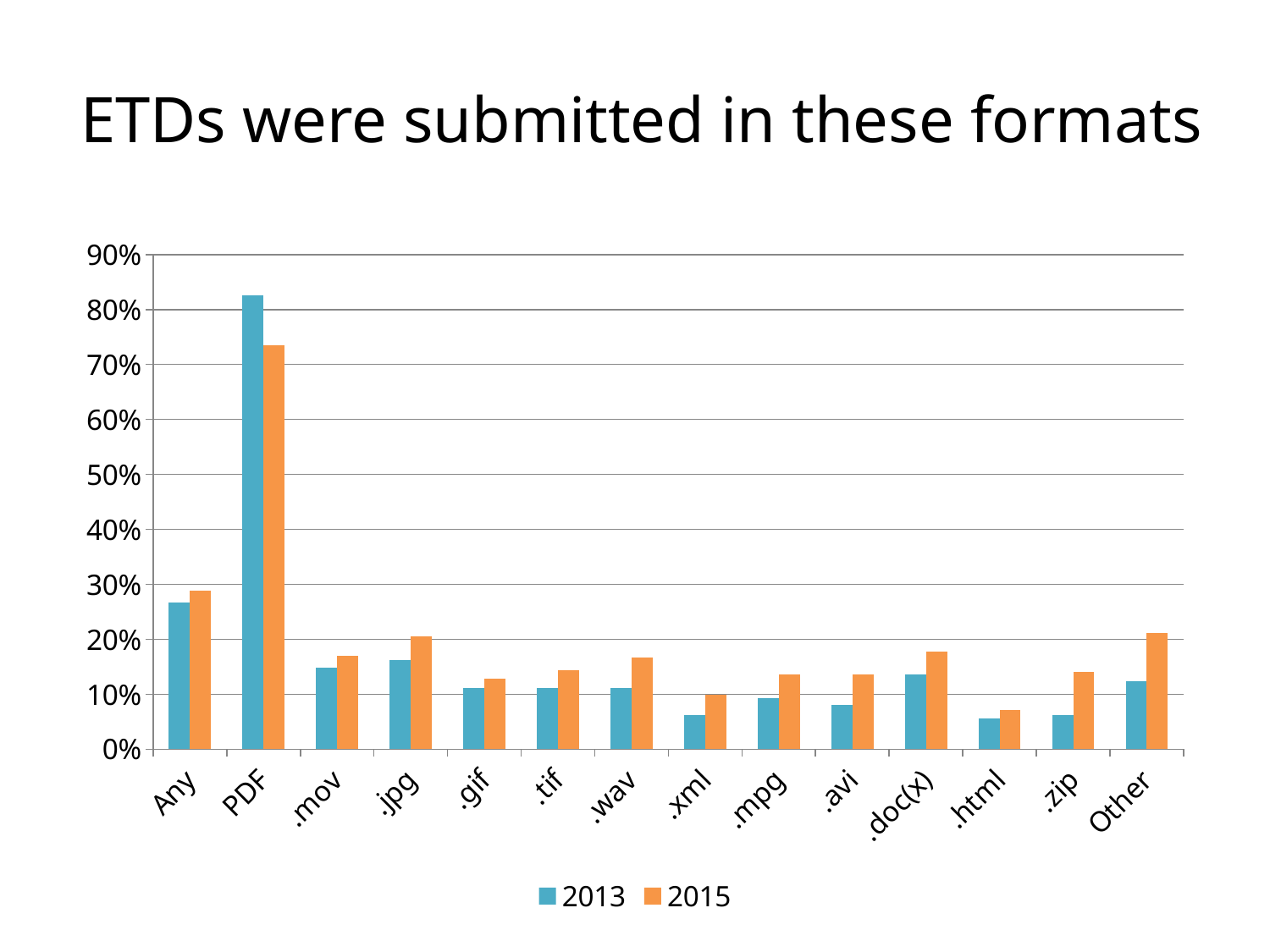
Which format has the lowest value for 2015? .html Which format has the highest value for 2013? PDF How many series does the legend list? 2 For PDF, which year has the larger value, 2013 or 2015? 2013 Is the 2013 value for PDF greater or less than 80%? greater Is the 2013 value for .xml greater or less than 10%? less What kind of chart is shown on the slide? bar chart How many file format categories are shown on the x axis? 14 For .zip, which year has the larger value, 2013 or 2015? 2015 Is the 2015 value for Other greater or less than 20%? greater What is the title of the chart? ETDs were submitted in these formats